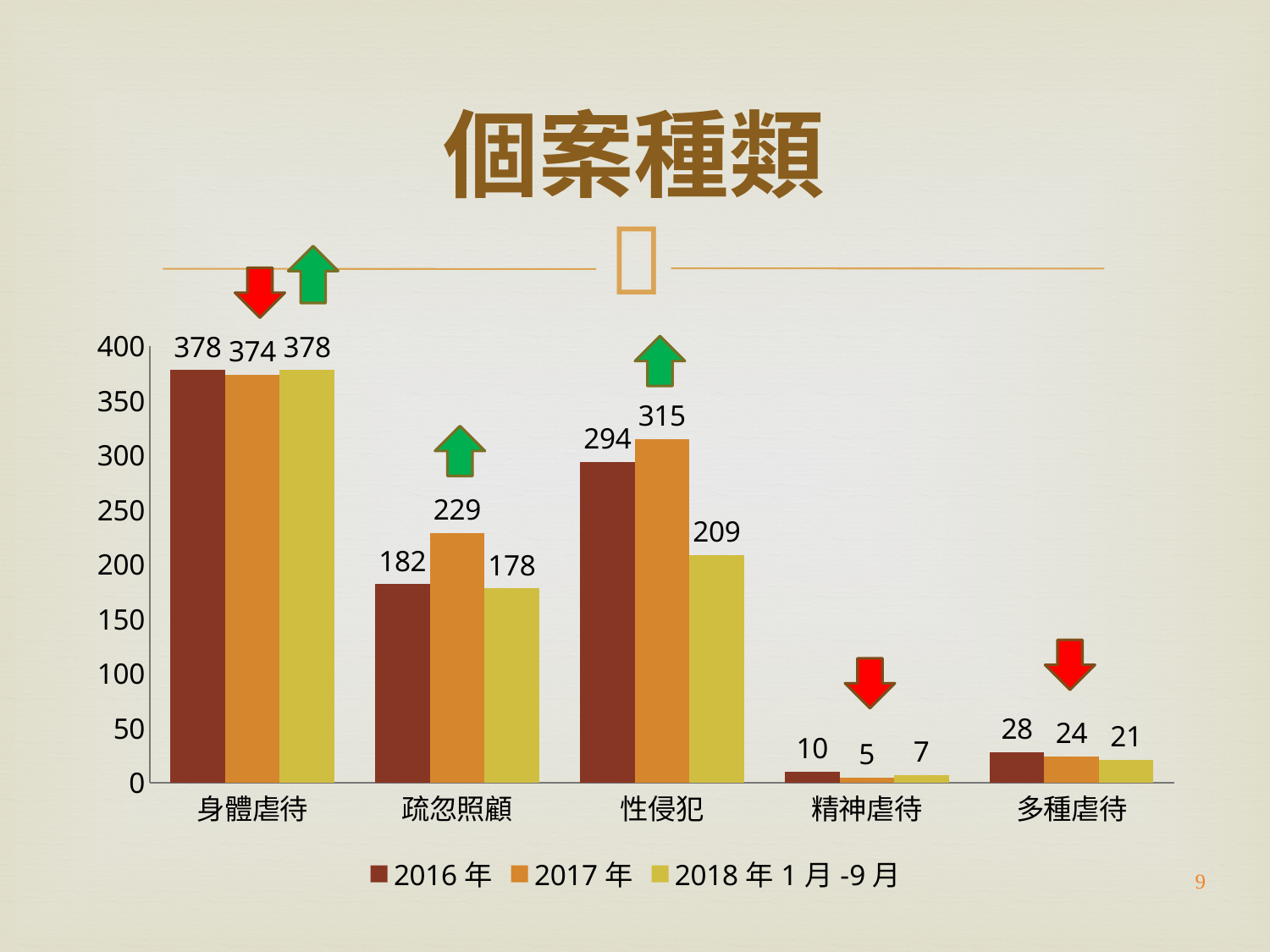
How many categories are shown on the x axis? 5 What is the difference between the 2016 年 and 2017 年 values for 多種虐待? 4 Which category has the lowest value in the 2017 年 series? 精神虐待 What is the difference between the 2017 年 and 2018 年 1 月 -9 月 values for 性侵犯? 106 Which is larger for 疏忽照顧: the 2016 年 value or the 2017 年 value? 2017 年 What is the value for 性侵犯 in the 2017 年 series? 315 How many series does the legend list? 3 What is the value for 精神虐待 in the 2018 年 1 月 -9 月 series? 7 Which category has the highest value in the 2018 年 1 月 -9 月 series? 身體虐待 What kind of chart is shown on the slide? bar chart What is the title of the chart? 個案種類 What is the value for 身體虐待 in the 2016 年 series? 378